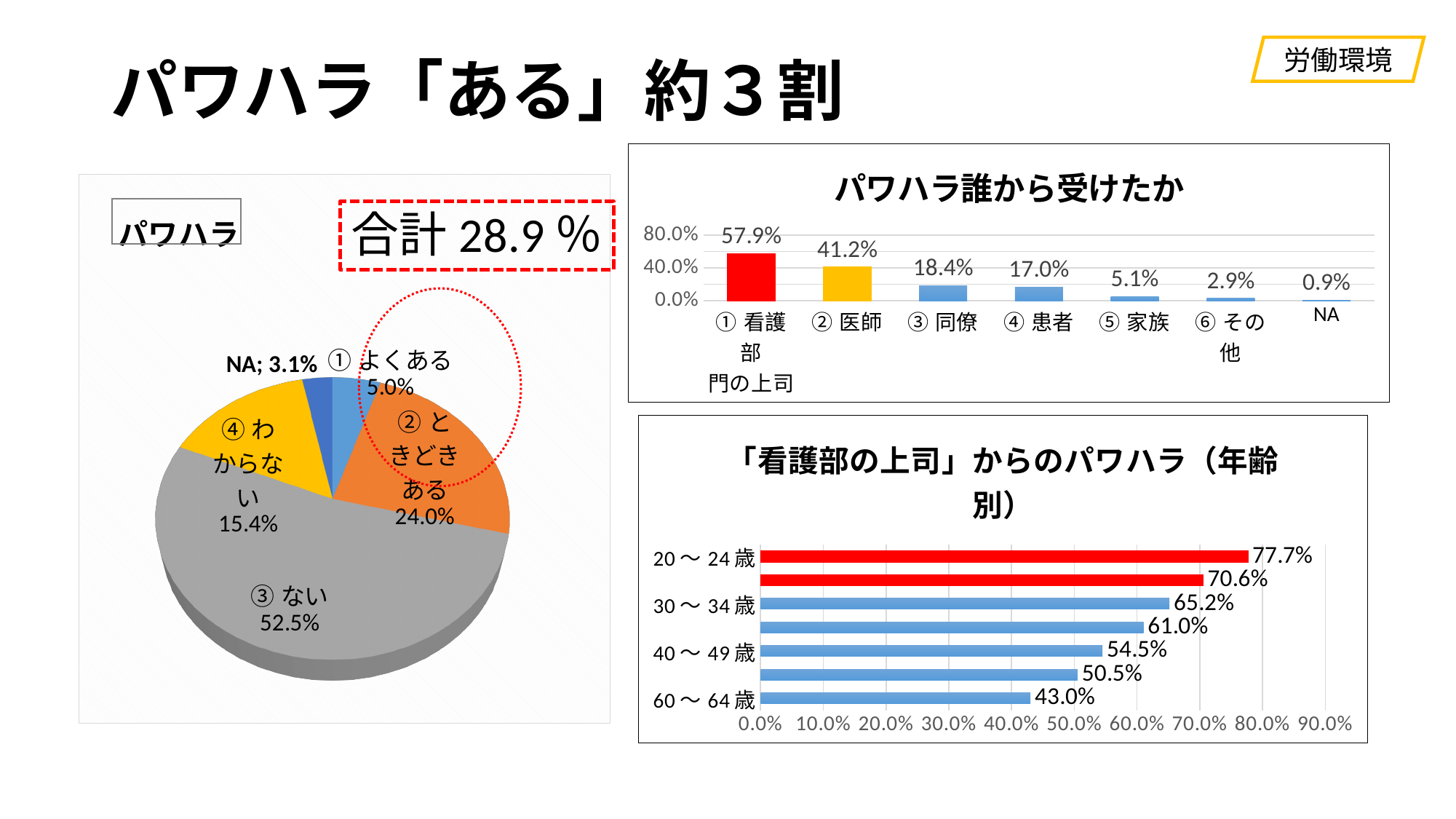
In the chart titled パワハラ誰から受けたか, what kind of chart is it? bar chart In the pie chart titled パワハラ, what is the difference between ④ わからない and ① よくある? 10.4% In the pie chart titled パワハラ, which category has the smallest slice? NA In the chart titled パワハラ誰から受けたか, what is the value for ② 医師? 41.2% In the chart titled パワハラ誰から受けたか, what is the difference between ③ 同僚 and ④ 患者? 1.4% In the chart titled 「看護部の上司」からのパワハラ（年齢別）, what is the value for 20～24歳? 77.7% In the pie chart titled パワハラ, what is the value for ② ときどきある? 24.0% In the pie chart titled パワハラ, what is the value for ③ ない? 52.5% In the chart titled 「看護部の上司」からのパワハラ（年齢別）, do the values rise or fall from the top bar to the bottom bar? fall In the chart titled パワハラ誰から受けたか, which category has the highest value? ① 看護部門の上司 In the chart titled パワハラ誰から受けたか, how many categories are shown? 7 In the chart titled 「看護部の上司」からのパワハラ（年齢別）, which is larger, 30～34歳 or 60～64歳? 30～34歳